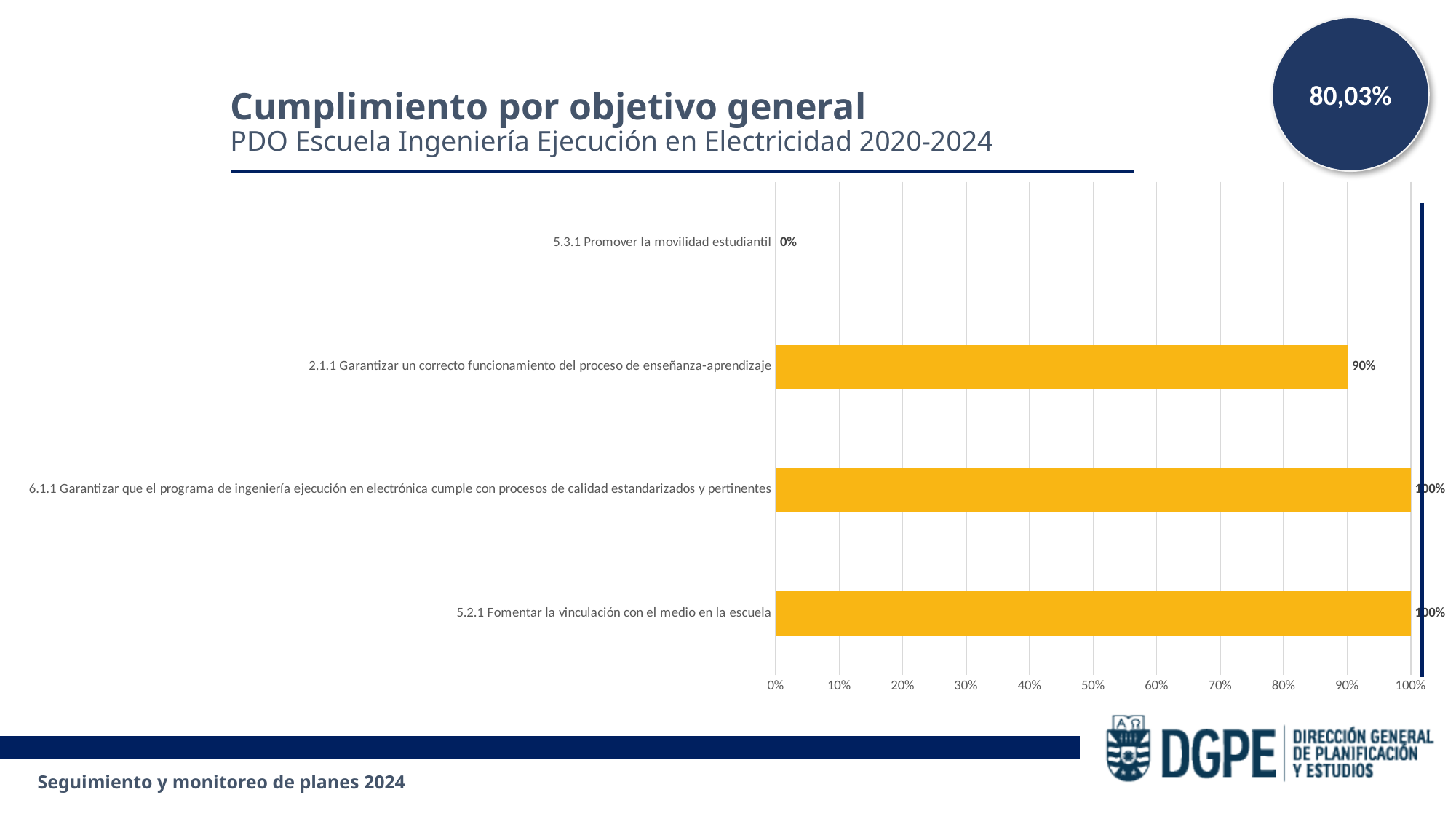
What is the value for 2.1.1 Garantizar un correcto funcionamiento del proceso de enseñanza-aprendizaje? 90% Which is larger, the value for 2.1.1 Garantizar un correcto funcionamiento del proceso de enseñanza-aprendizaje or the value for 5.3.1 Promover la movilidad estudiantil? 2.1.1 Garantizar un correcto funcionamiento del proceso de enseñanza-aprendizaje What is the title of the chart? Cumplimiento por objetivo general What kind of chart is shown on the slide? bar chart What is the value for 5.3.1 Promover la movilidad estudiantil? 0% Is the value for 2.1.1 Garantizar un correcto funcionamiento del proceso de enseñanza-aprendizaje greater or less than 50%? greater How many objectives are shown in the chart? 4 How many objectives have a value of 100%? 2 Which objective has the lowest value? 5.3.1 Promover la movilidad estudiantil What is the value for 6.1.1 Garantizar que el programa de ingeniería ejecución en electrónica cumple con procesos de calidad estandarizados y pertinentes? 100% What is the value for 5.2.1 Fomentar la vinculación con el medio en la escuela? 100% What is the difference between the values for 5.2.1 Fomentar la vinculación con el medio en la escuela and 2.1.1 Garantizar un correcto funcionamiento del proceso de enseñanza-aprendizaje? 10%